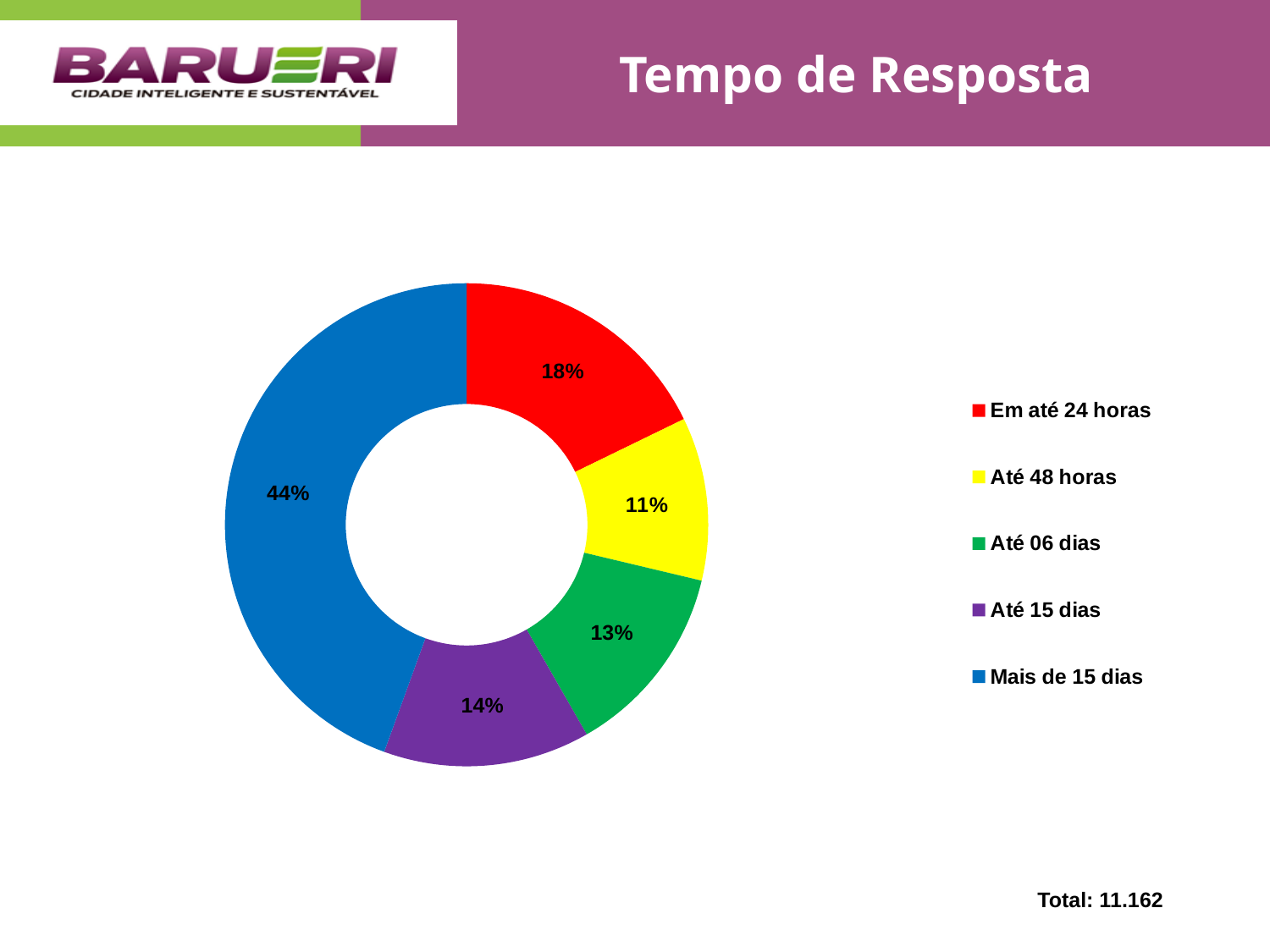
What is the value shown for 'Até 48 horas'? 11% What is the value shown for 'Em até 24 horas'? 18% What is the value shown for 'Até 06 dias'? 13% How many categories does the chart show? 5 Which is larger, the share for 'Em até 24 horas' or the share for 'Até 06 dias'? Em até 24 horas What kind of chart is shown on the slide? Pie chart (doughnut) Which category has the largest share of the chart? Mais de 15 dias What is the difference in percentage points between 'Mais de 15 dias' and 'Em até 24 horas'? 26 Which category has the smallest share of the chart? Até 48 horas What is the value shown for 'Até 15 dias'? 14% What colour represents 'Até 15 dias' in the legend? Purple What share of the pie does 'Mais de 15 dias' represent? 44%